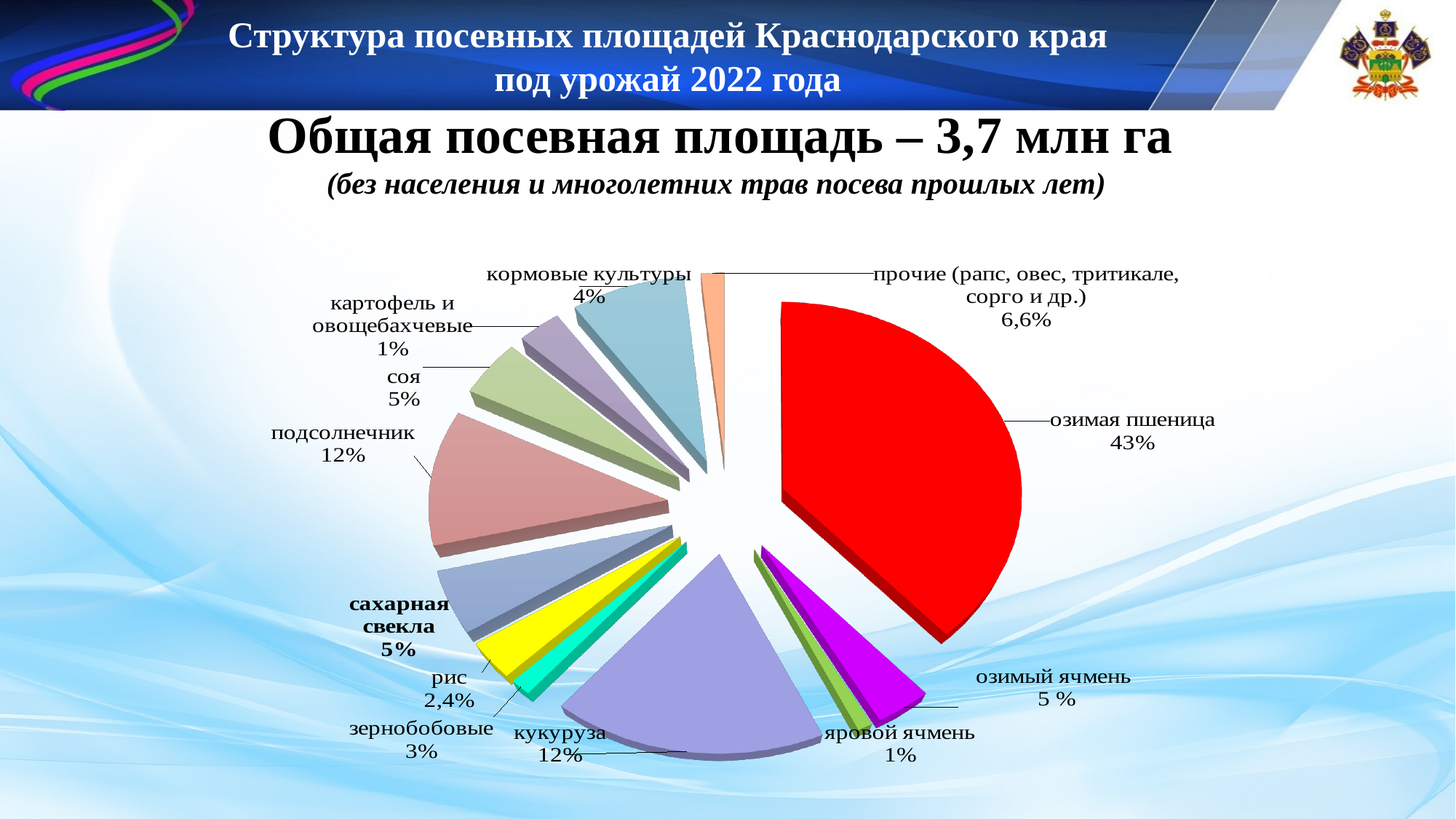
What share of the sown area is кормовые культуры? 4% What share of the sown area is рис? 2,4% What share of the sown area is озимая пшеница? 43% What total sown area is stated above the chart? 3,7 млн га What share is shown for прочие (рапс, овес, тритикале, сорго и др.)? 6,6% What is the difference in share between зернобобовые and рис? 0,6% What is the difference in share between озимая пшеница and кукуруза? 31% What kind of chart is shown on the slide? pie chart What share of the sown area is подсолнечник? 12% Which crop has the largest share of the sown area? озимая пшеница How many slices does the pie chart have? 12 Which has the larger share, кукуруза or соя? кукуруза